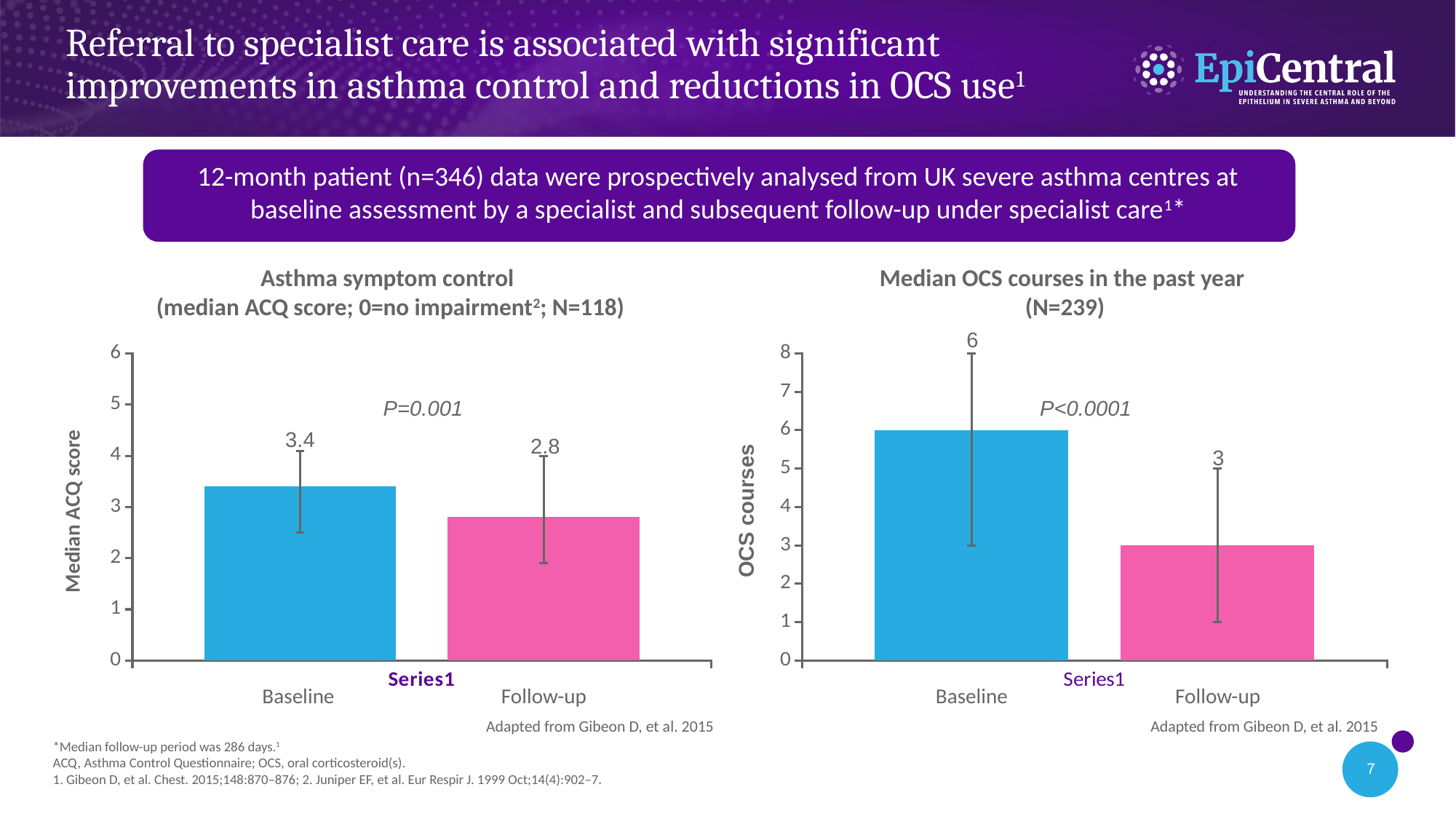
In the Median OCS courses in the past year chart, what is the difference between the Baseline and Follow-up values? 3 How many categories are shown on the x axis of the Asthma symptom control chart? 2 In the Median OCS courses in the past year chart, what is the value at Follow-up? 3 In the Median OCS courses in the past year chart, do the values rise or fall from Baseline to Follow-up? Fall What kind of chart is the Median OCS courses in the past year chart? Bar chart In the Median OCS courses in the past year chart, what is the value at Baseline? 6 What is the y-axis label of the Asthma symptom control chart? Median ACQ score In the Asthma symptom control chart, what is the median ACQ score at Baseline? 3.4 In the Asthma symptom control chart, what is the difference between the Baseline and Follow-up median ACQ scores? 0.6 In the Median OCS courses in the past year chart, which category has the higher value, Baseline or Follow-up? Baseline In the Asthma symptom control chart, what is the median ACQ score at Follow-up? 2.8 In the Asthma symptom control chart, which category has the lowest median ACQ score? Follow-up